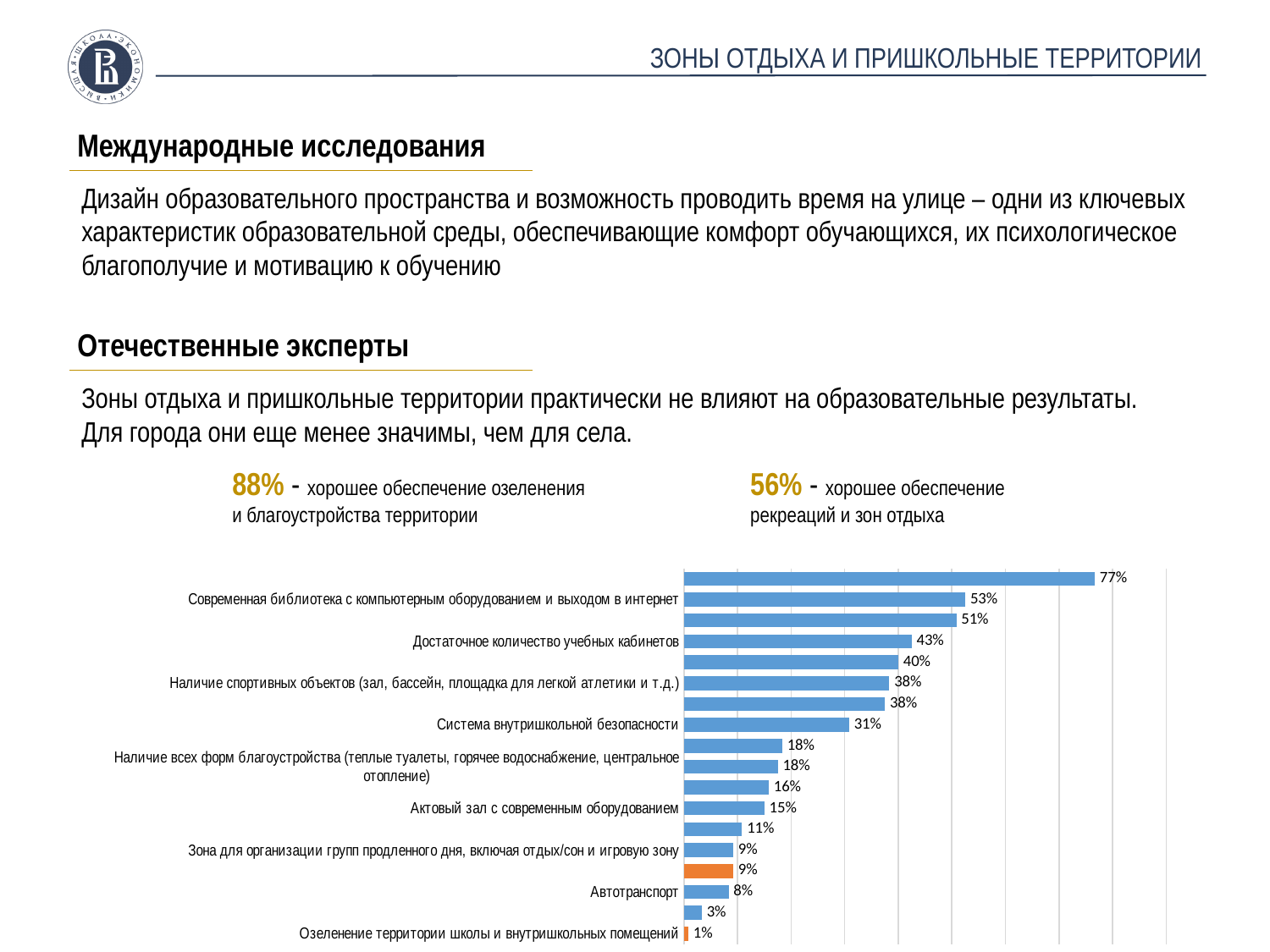
What is the value for "Система внутришкольной безопасности"? 31% What type of chart is shown on the slide? bar chart What is the value for "Достаточное количество учебных кабинетов"? 43% Which labeled category has the lowest value in the chart? Озеленение территории школы и внутришкольных помещений What is the value for "Озеленение территории школы и внутришкольных помещений"? 1% Which is larger: the value for "Система внутришкольной безопасности" or for "Актовый зал с современным оборудованием"? Система внутришкольной безопасности How many bars are plotted in the chart? 18 What is the value for "Современная библиотека с компьютерным оборудованием и выходом в интернет"? 53% What is the value for "Автотранспорт"? 8% What is the value for "Актовый зал с современным оборудованием"? 15% What is the difference between the values for "Современная библиотека с компьютерным оборудованием и выходом в интернет" and "Достаточное количество учебных кабинетов"? 10% What is the highest value shown in the chart? 77%